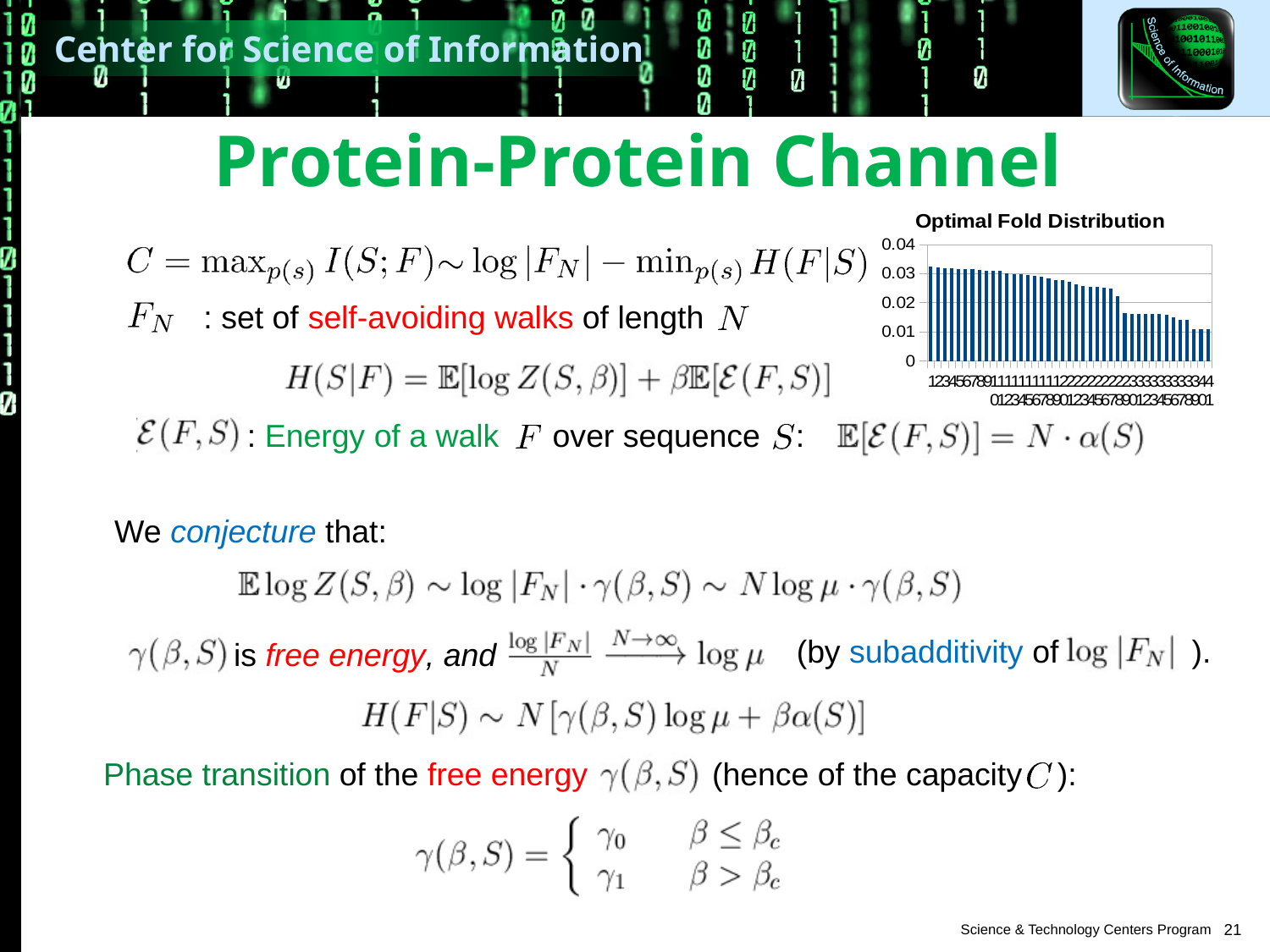
In the "Optimal Fold Distribution" chart, is the value for category 41 greater or less than 0.02? less In the "Optimal Fold Distribution" chart, which is larger, the value for category 15 or the value for category 35? category 15 What is the title of the chart on the slide? Optimal Fold Distribution In the "Optimal Fold Distribution" chart, is the value for category 20 greater or less than 0.02? greater In the "Optimal Fold Distribution" chart, which is larger, the value for category 1 or the value for category 41? category 1 In the "Optimal Fold Distribution" chart, is the value for category 5 greater or less than 0.04? less What kind of chart is the "Optimal Fold Distribution" chart? bar chart In the "Optimal Fold Distribution" chart, do the values generally rise or fall from left to right along the x axis? fall How many categories are plotted along the x axis of the "Optimal Fold Distribution" chart? 41 What is the highest value shown on the y axis of the "Optimal Fold Distribution" chart? 0.04